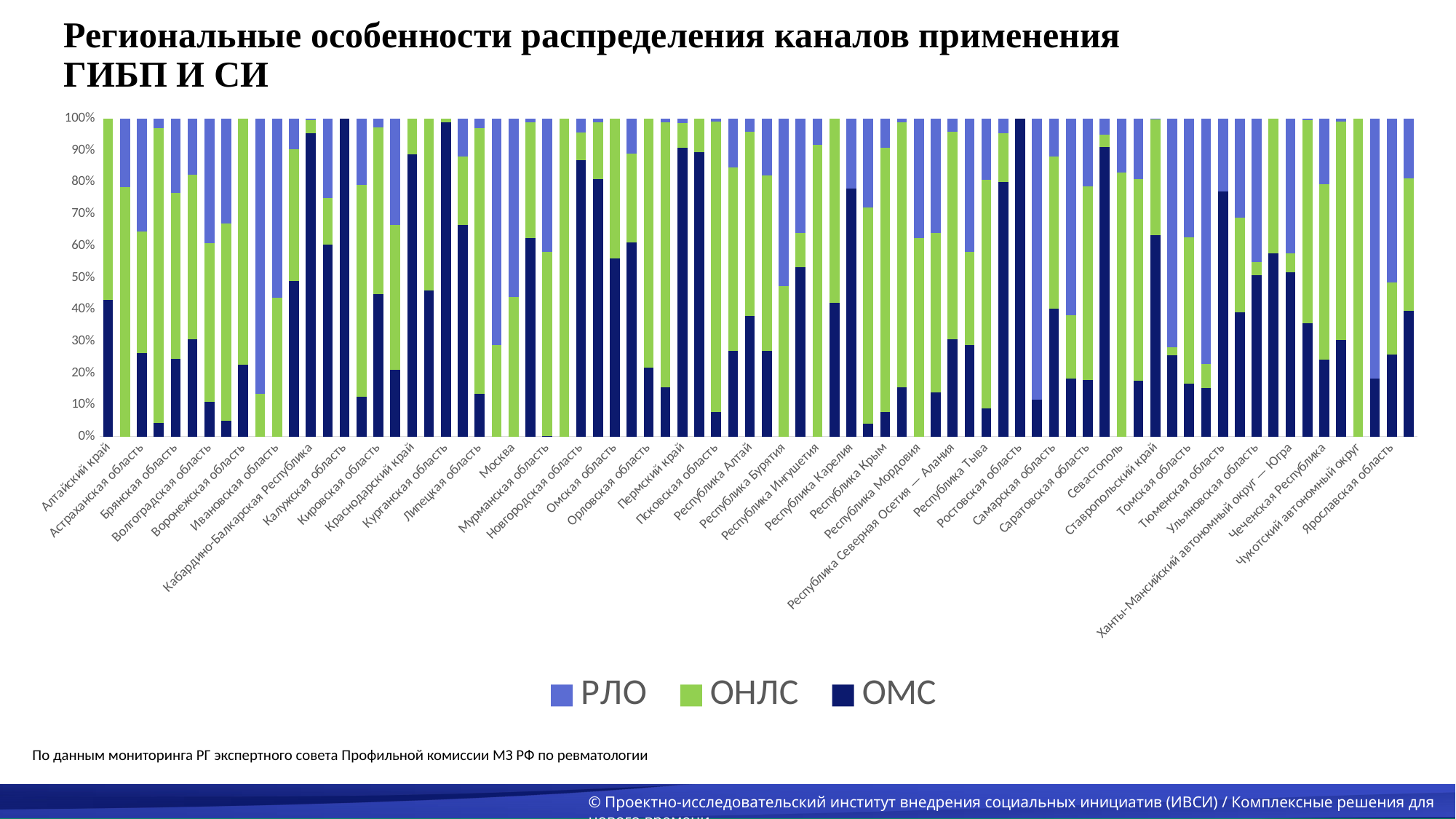
How many series does the legend list? 3 What is the highest value shown on the y axis? 100% What kind of chart is shown on the slide? stacked bar chart Is the ОМС share for Алтайский край (the first bar) greater or less than 30%? greater Is the ОМС share for Алтайский край (the first bar) greater or less than 50%? less What are the three series named in the legend? РЛО, ОНЛС, ОМС Which series is shown in dark navy blue in the legend? ОМС